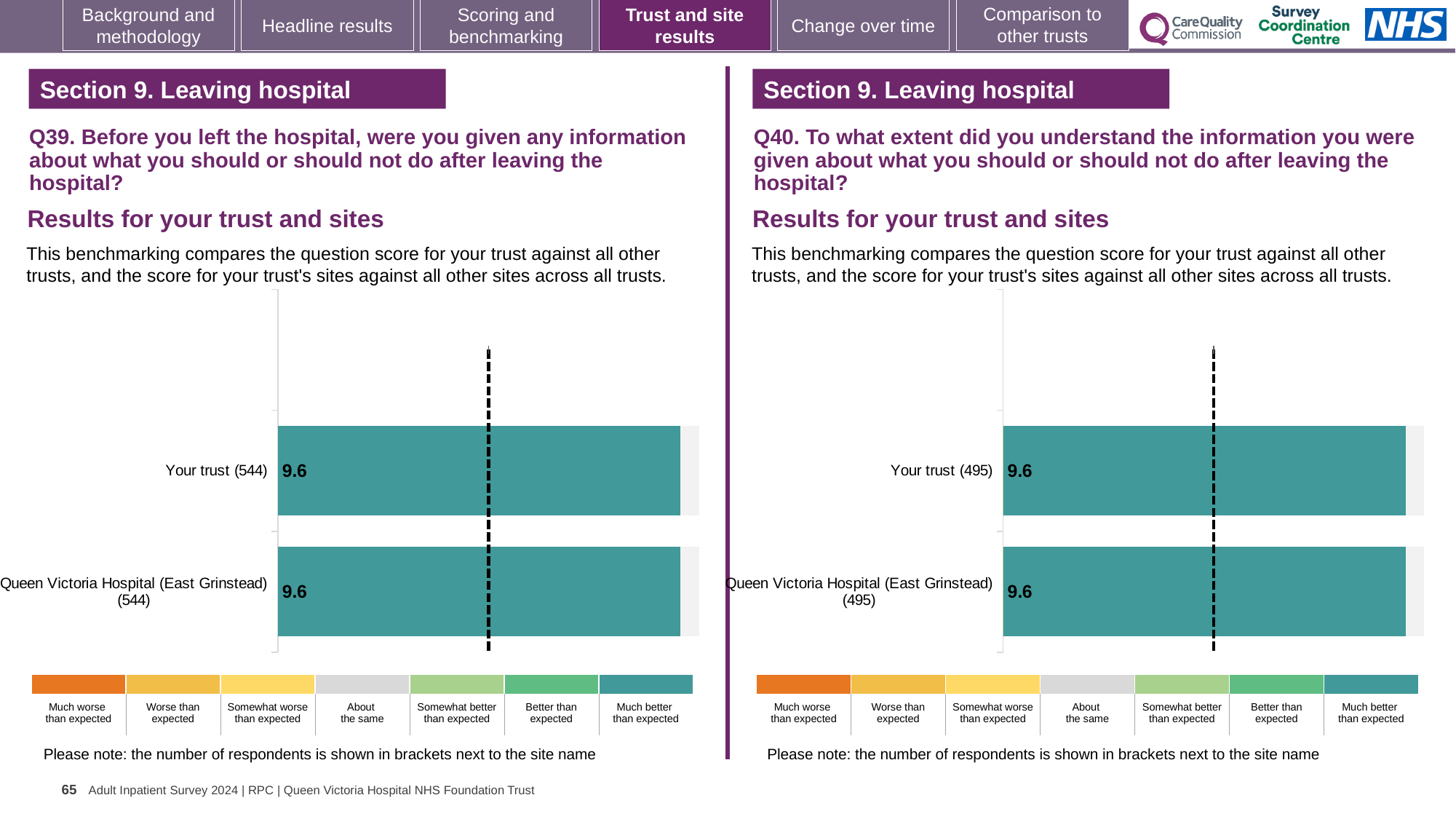
How many bars are plotted on the Q40 chart (right)? 2 On the Q39 chart (left), what is the score for Queen Victoria Hospital (East Grinstead)? 9.6 What kind of chart is used for the Q39 results (left)? Bar chart On the Q39 chart (left), how many respondents are shown in brackets for Your trust? 544 On the Q40 chart (right), how many respondents are shown in brackets for Queen Victoria Hospital (East Grinstead)? 495 On the Q40 chart (right), what is the difference between the score for Your trust and the score for Queen Victoria Hospital (East Grinstead)? 0.0 How many bars are plotted on the Q39 chart (left)? 2 On the Q39 chart (left), what is the score for Your trust? 9.6 On the Q39 chart (left), what is the difference between the score for Your trust and the score for Queen Victoria Hospital (East Grinstead)? 0.0 On the Q40 chart (right), what is the score for Queen Victoria Hospital (East Grinstead)? 9.6 According to the colour key below the Q40 chart (right), which benchmark category does the teal colour of the bars represent? Much better than expected On the Q40 chart (right), what is the score for Your trust? 9.6